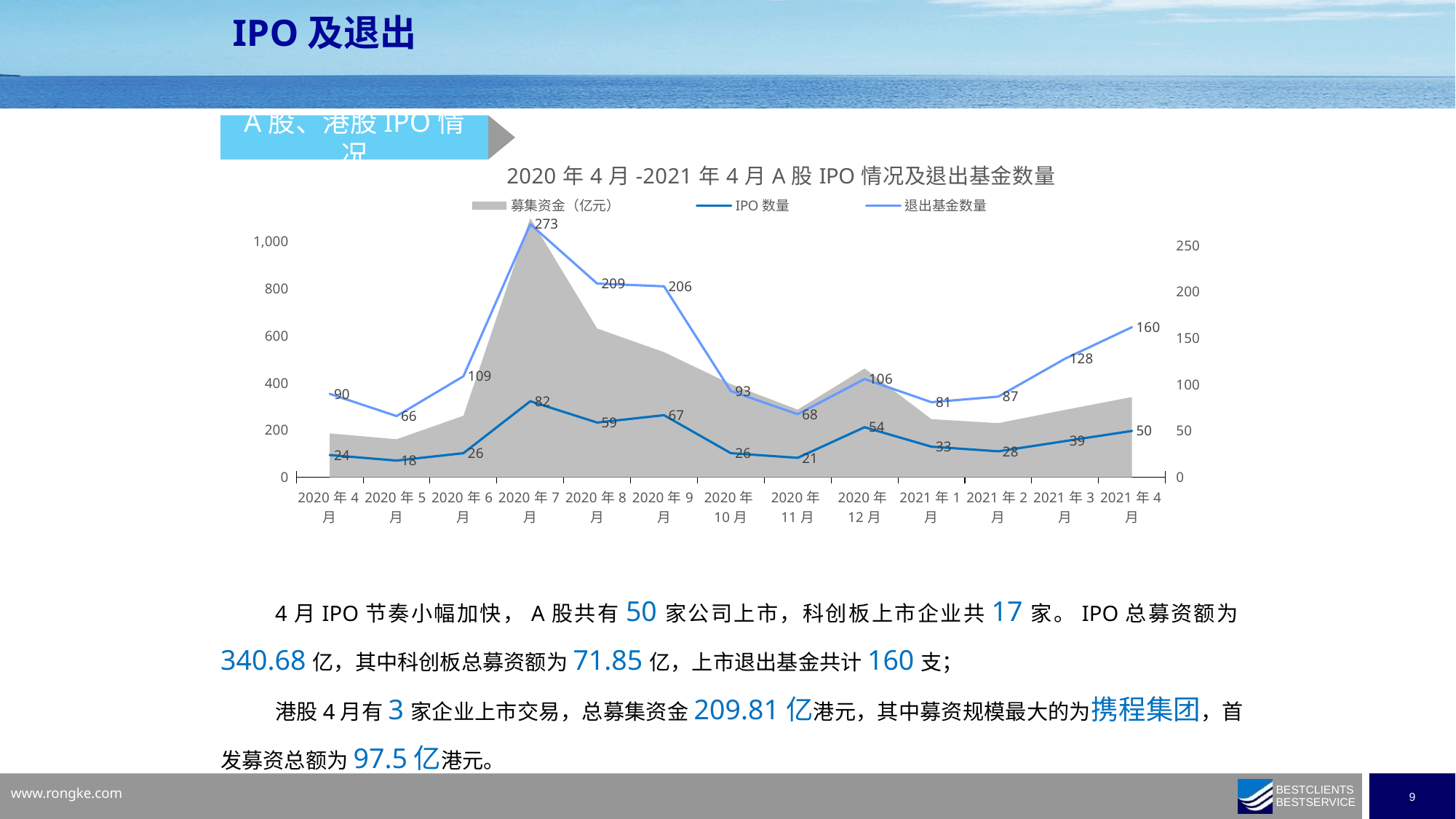
What is the difference between the 退出基金数量 values for 2020年8月 and 2020年9月? 3 Is the 募集资金（亿元） value for 2020年7月 greater or less than 800? greater Does the 退出基金数量 series rise or fall from 2021年1月 to 2021年4月? rise What is the 退出基金数量 value for 2020年11月? 68 What is the 退出基金数量 value for 2021年4月? 160 Which month has the lowest IPO数量? 2020年5月 How many months are shown on the x axis of the chart? 13 Which is larger, the IPO数量 for 2020年12月 or for 2021年4月? 2020年12月 How many series does the chart legend list? 3 What is the IPO数量 value for 2020年7月? 82 Which month has the highest 退出基金数量? 2020年7月 Is the 募集资金（亿元） value for 2020年4月 greater or less than 400? less